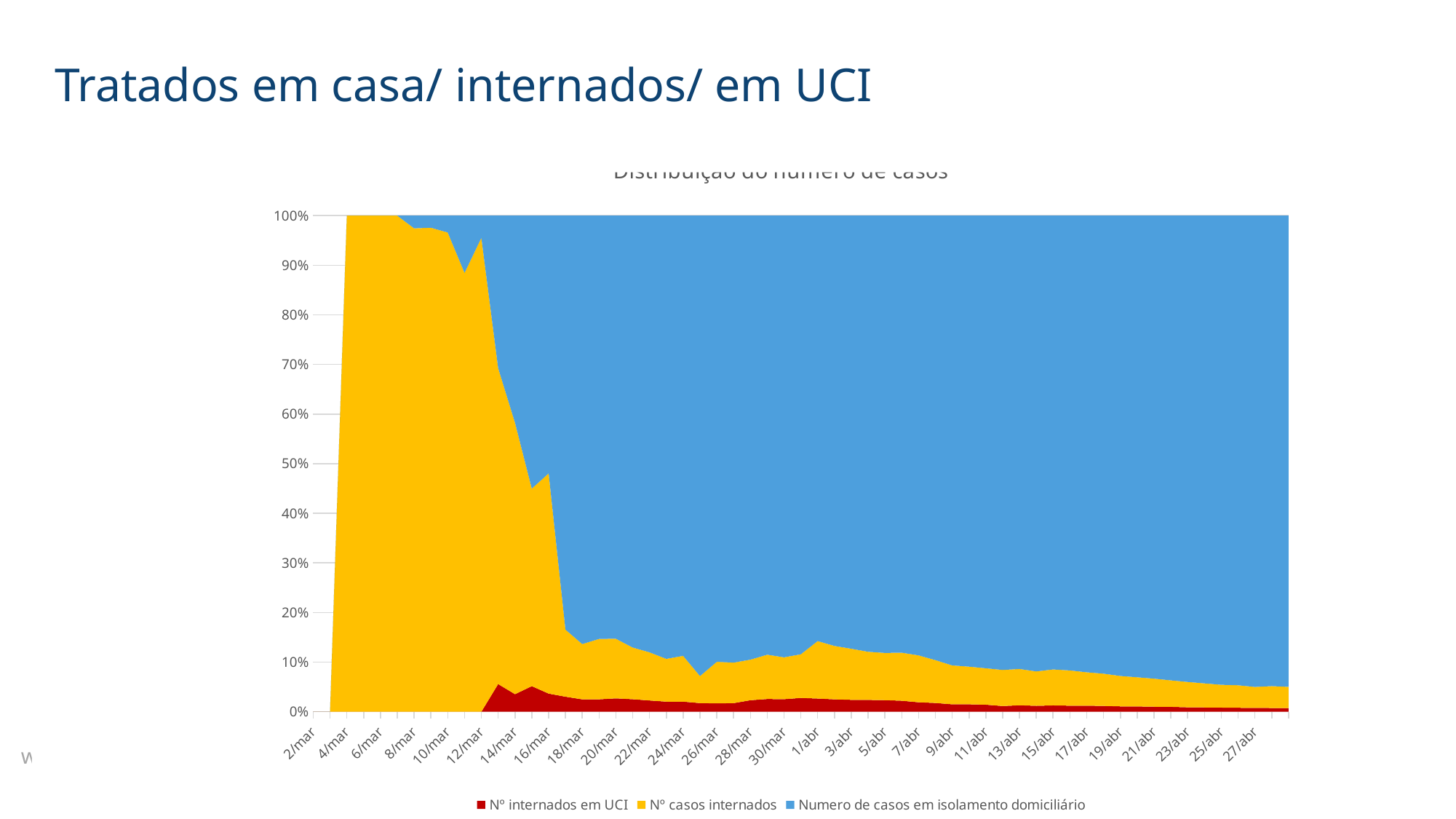
Is the share of 'Numero de casos em isolamento domiciliário' on 27/abr greater or less than 90%? greater On 6/mar, which series has the larger share: 'Nº casos internados' or 'Numero de casos em isolamento domiciliário'? Nº casos internados Which series is shown in red in the chart? Nº internados em UCI Is the share of 'Numero de casos em isolamento domiciliário' on 6/mar greater or less than 10%? less Does the share of 'Numero de casos em isolamento domiciliário' rise or fall from early March to late April? Rise What kind of chart is shown on the slide? Stacked area chart On 27/abr, which series has the larger share: 'Nº casos internados' or 'Numero de casos em isolamento domiciliário'? Numero de casos em isolamento domiciliário Is the share of 'Nº casos internados' on 6/mar greater or less than 90%? greater How many series does the legend list? 3 Which series is shown in blue in the chart? Numero de casos em isolamento domiciliário Does the share of 'Nº casos internados' rise or fall from early March to late April? Fall